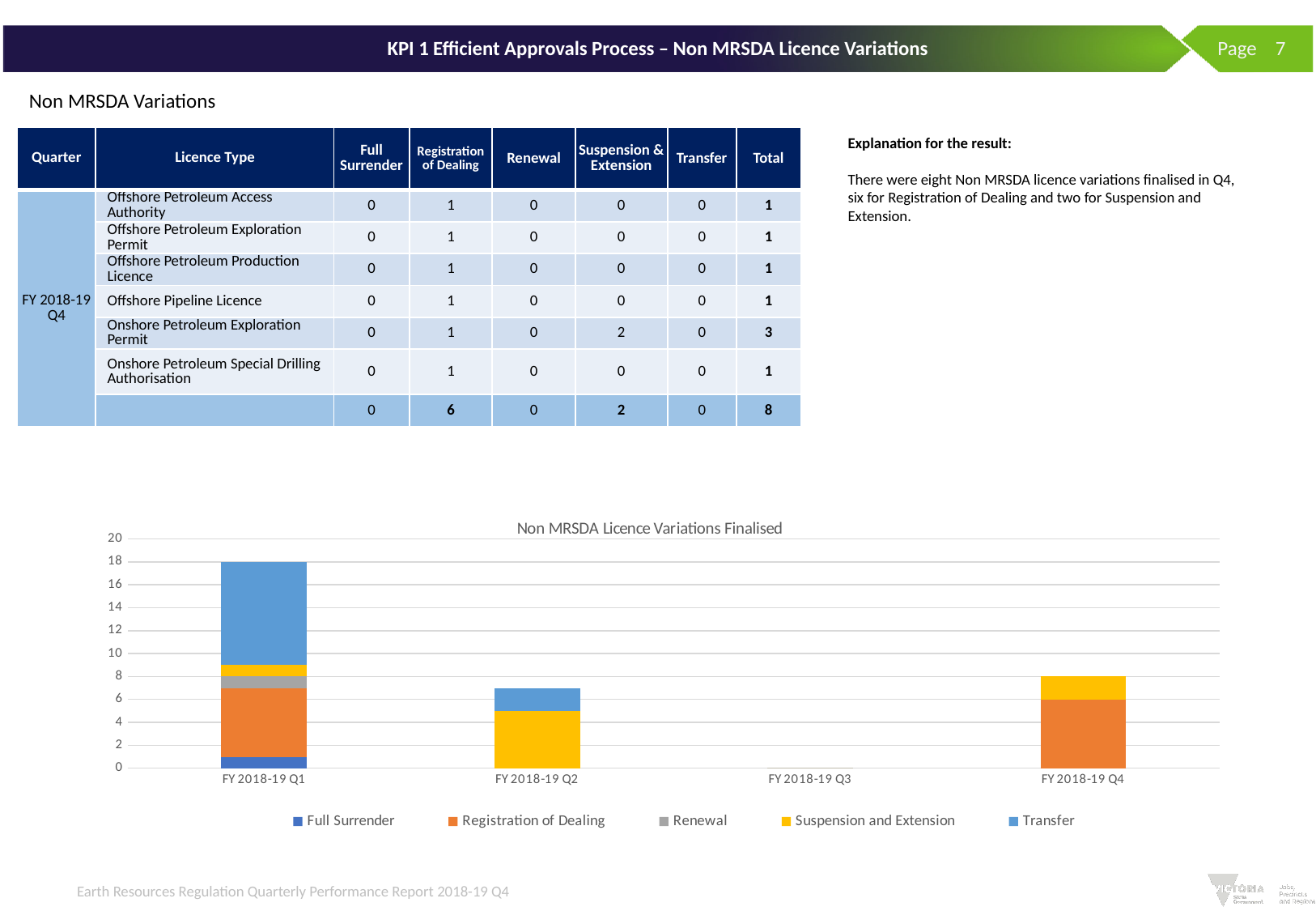
Which quarter has the lowest total bar in the chart? FY 2018-19 Q3 What is the total height of the bar for FY 2018-19 Q1? 18 What is the total height of the bar for FY 2018-19 Q4? 8 How many quarters are shown on the x axis of the chart? 4 Which quarter has a larger total bar, FY 2018-19 Q1 or FY 2018-19 Q4? FY 2018-19 Q1 What colour represents Registration of Dealing in the chart legend? orange How many series does the chart legend list? 5 What kind of chart is shown on the slide? bar chart Is the Registration of Dealing segment for FY 2018-19 Q4 greater or less than 4? greater Which quarter has the highest total bar in the chart? FY 2018-19 Q1 Is the total bar for FY 2018-19 Q2 greater or less than 10? less What is the title of the chart? Non MRSDA Licence Variations Finalised